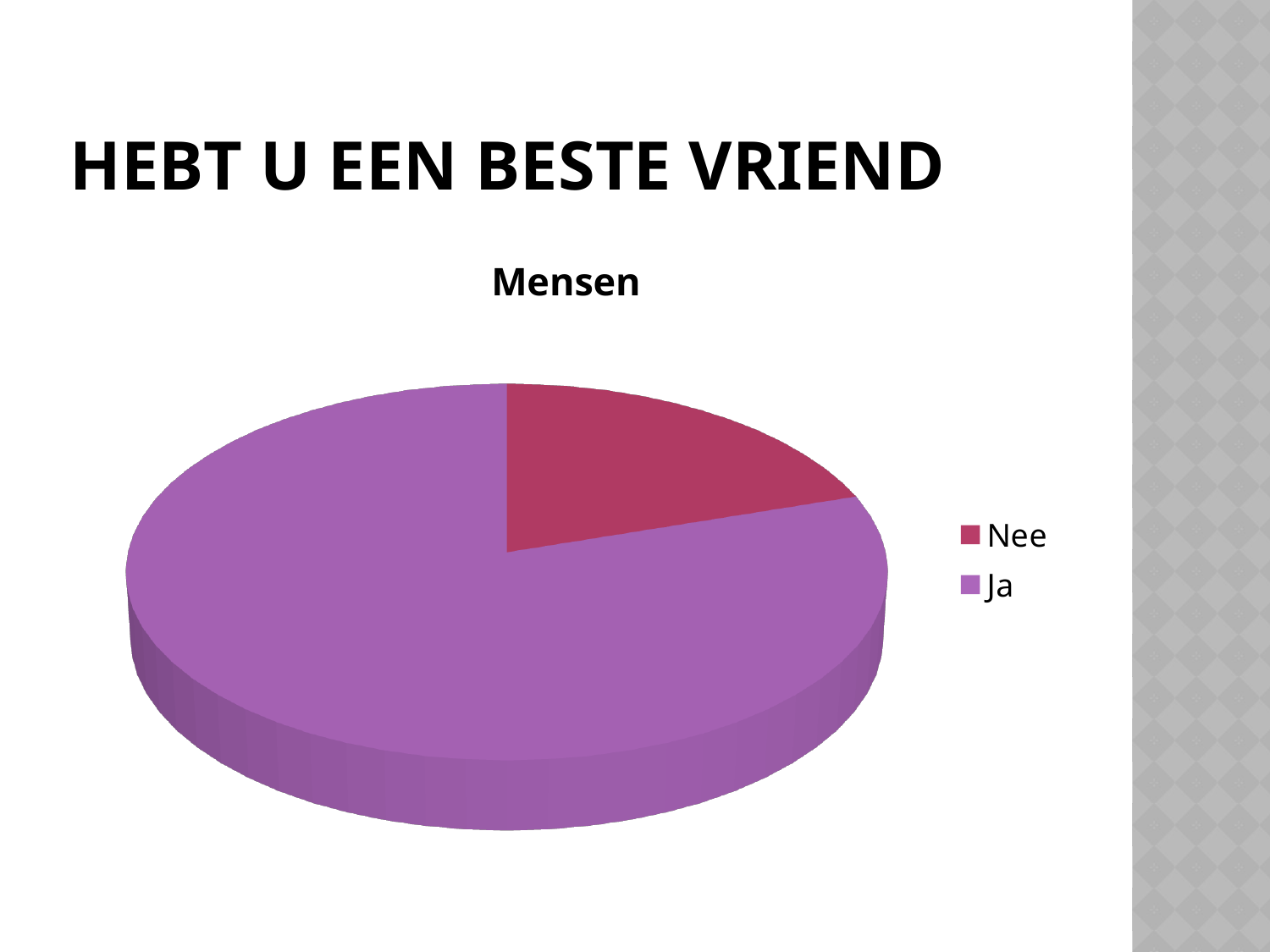
Which slice is larger, Ja or Nee? Ja Which category has the smallest slice of the pie? Nee What colour is the slice for Nee? red What is the title of the chart? Mensen How many categories does the legend list? 2 What kind of chart is shown on the slide? pie chart Which category has the largest slice of the pie? Ja Does the Ja slice take up more or less than half of the pie? more